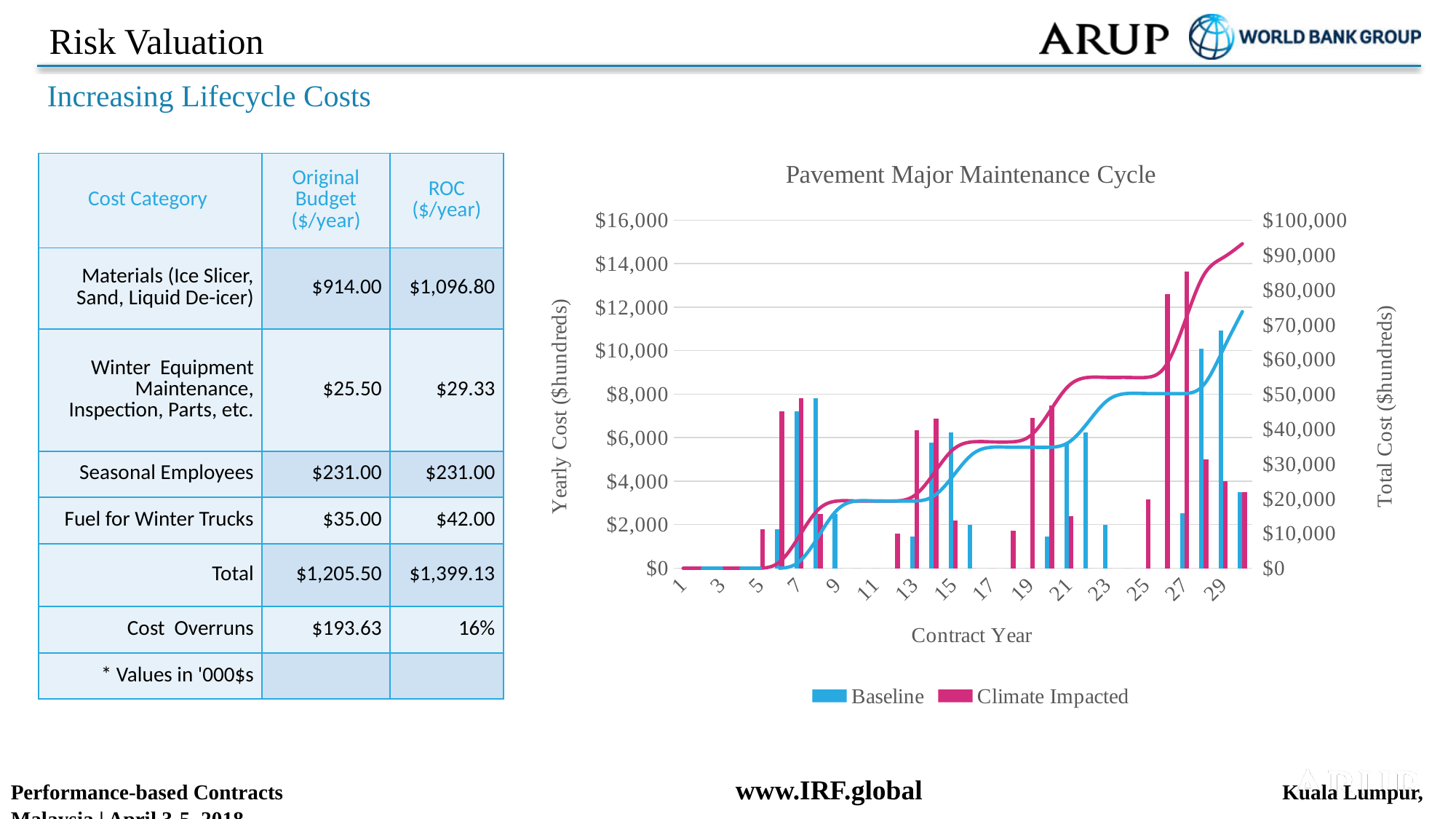
How many series does the chart's legend list? 2 What kind of chart is shown on the slide? Combined bar and line chart At the end of the contract period, which line is higher: Baseline or Climate Impacted? Climate Impacted Do the Total Cost lines in the chart rise or fall as the contract year increases? Rise At contract year 27, which bar is taller: Baseline or Climate Impacted? Climate Impacted Is the Baseline bar at contract year 29 greater or less than $10,000? greater Is the Climate Impacted bar at contract year 27 greater or less than $12,000? greater Is the Baseline bar at contract year 27 greater or less than $4,000? less What is the title of the chart on the slide? Pavement Major Maintenance Cycle Which series has the tallest bar in the chart? Climate Impacted What are the two series named in the chart's legend? Baseline and Climate Impacted At contract year 29, which bar is taller: Baseline or Climate Impacted? Baseline